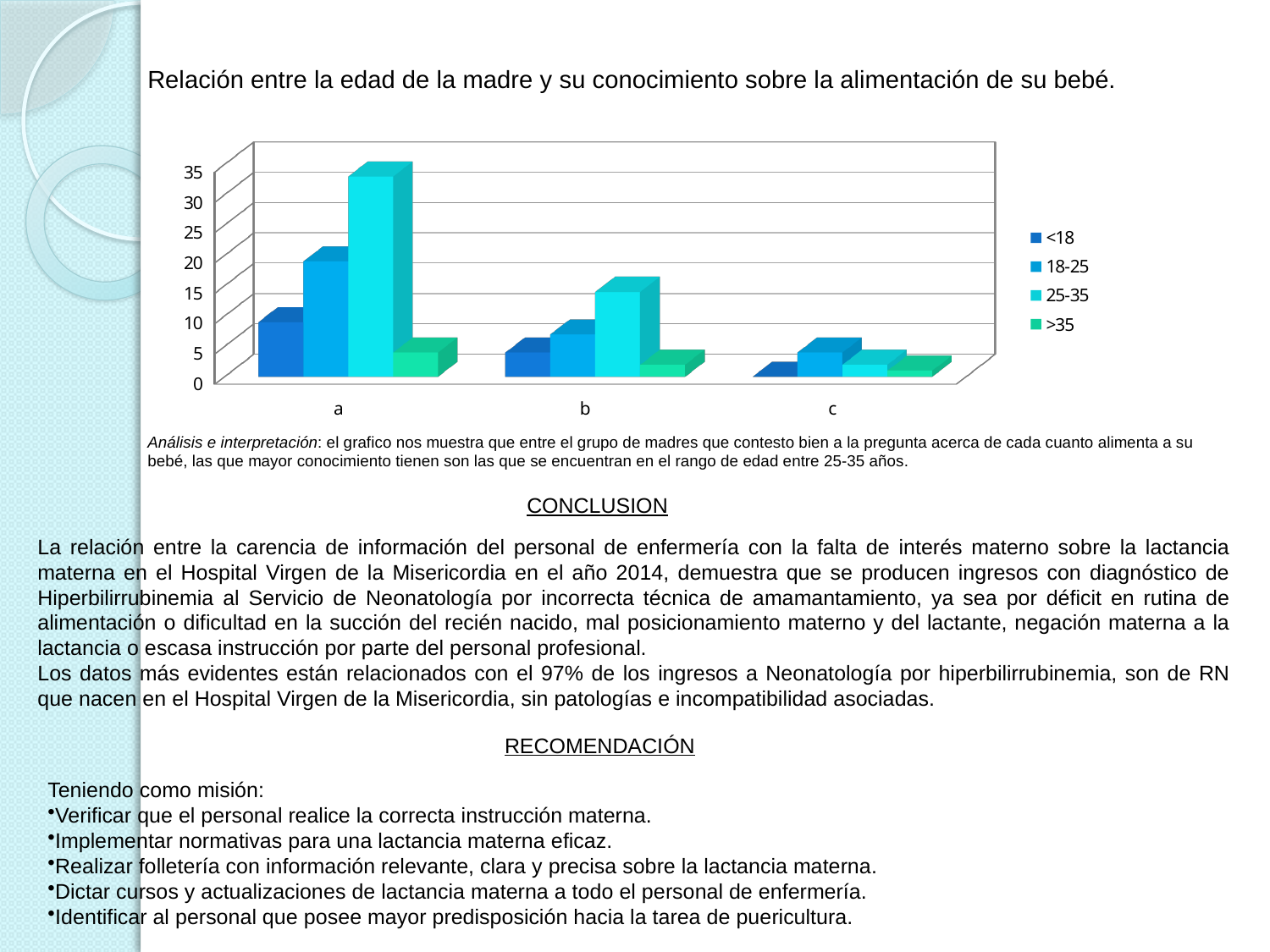
How many categories are shown on the x axis? 3 Is the value for >35 in category a greater or less than 10? less Which is larger in category a: the 18-25 value or the 25-35 value? 25-35 Which age group has the highest value in category a? 25-35 Is the value for 25-35 in category a greater or less than 25? greater How many series does the legend list? 4 Which category has the highest value for the 25-35 series? a Is the value for 25-35 in category b greater or less than 10? greater Which category has the lowest value for the 25-35 series? c Does the 25-35 series rise or fall from category a to category c? fall What type of chart is shown on the slide? bar chart